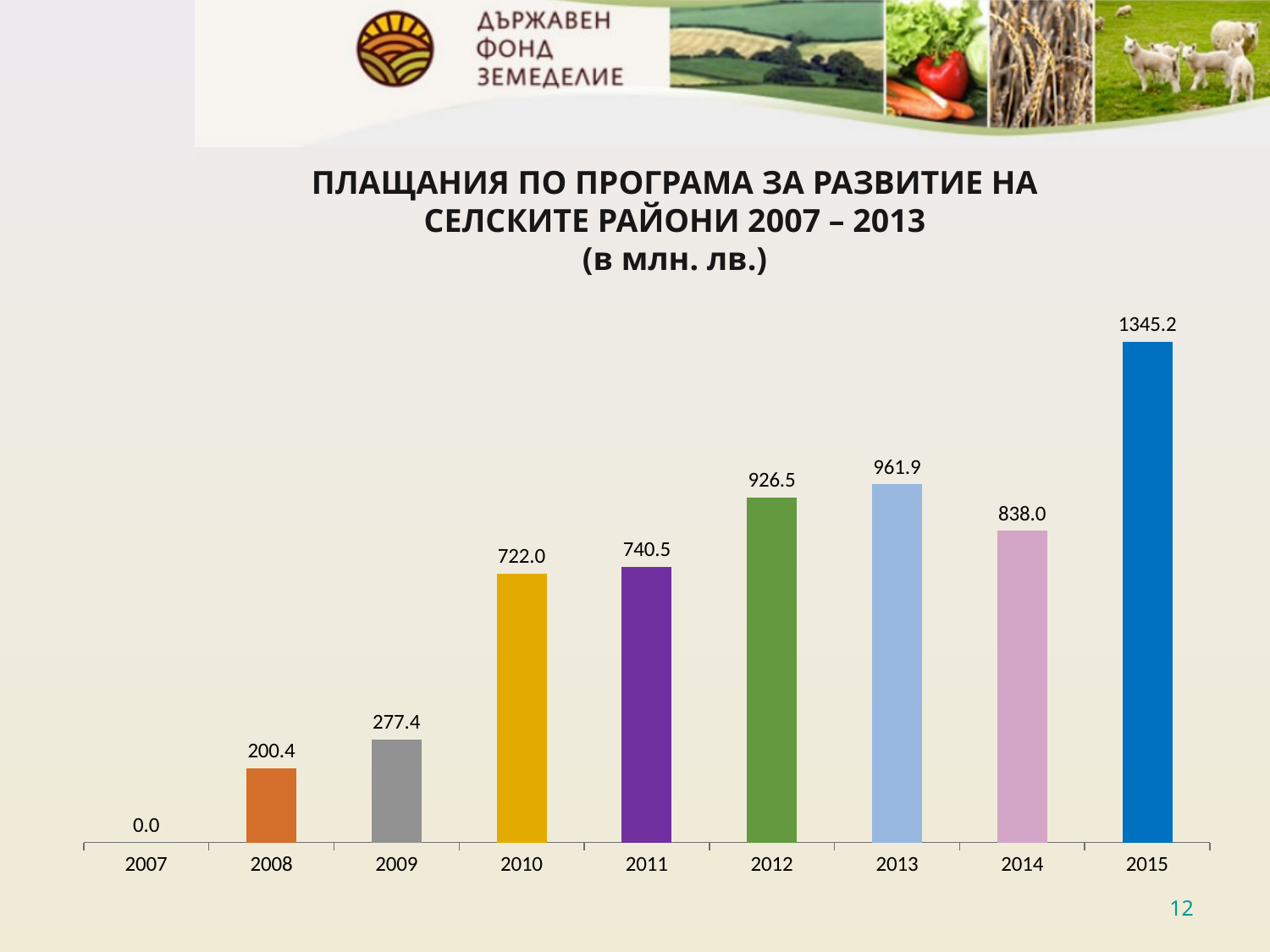
Which year has the lowest value? 2007 Which year has the highest value? 2015 What unit is given in the chart title? млн. лв. What is the value for 2010? 722.0 What kind of chart is shown on the slide? bar chart Do the values generally rise or fall from 2007 to 2013? rise How many years are shown on the x axis? 9 What is the value for 2015? 1345.2 What is the difference between the values for 2013 and 2014? 123.9 Which is larger, the value for 2012 or the value for 2011? 2012 What is the value for 2008? 200.4 What is the difference between the values for 2009 and 2008? 77.0